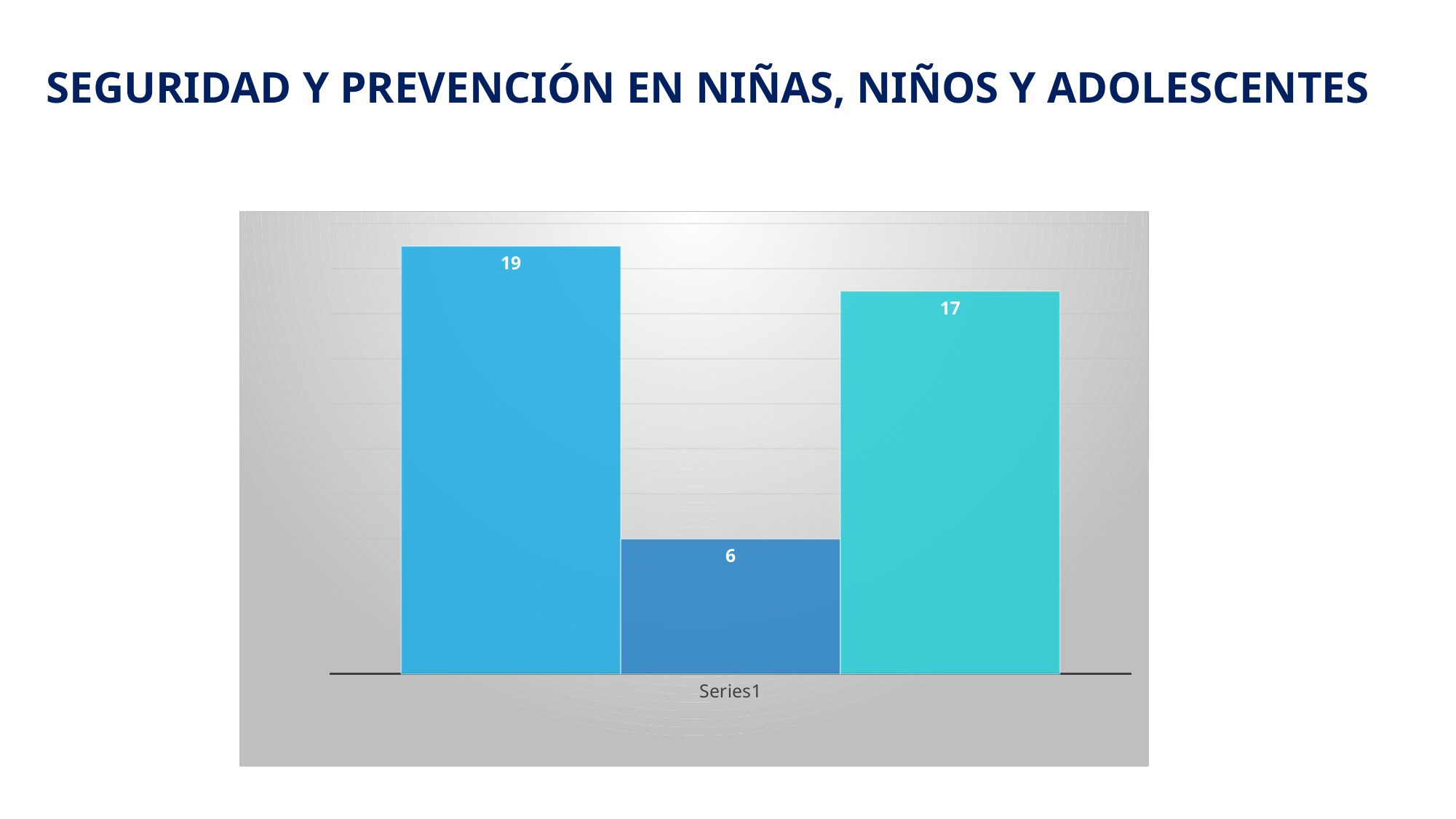
Which bar has the highest value: the left, middle or right bar? left What is the value shown on the leftmost bar? 19 What type of chart is shown on the slide? bar chart Which bar has the lowest value: the left, middle or right bar? middle What is the value shown on the rightmost bar? 17 What is the title of the slide containing the chart? SEGURIDAD Y PREVENCIÓN EN NIÑAS, NIÑOS Y ADOLESCENTES What is the value shown on the middle bar? 6 What is the difference between the values of the leftmost bar and the middle bar? 13 How many bars are plotted in the chart? 3 What is the difference between the values of the leftmost bar and the rightmost bar? 2 What label appears on the horizontal axis below the bars? Series1 Which is larger, the value of the middle bar or the value of the rightmost bar? the rightmost bar